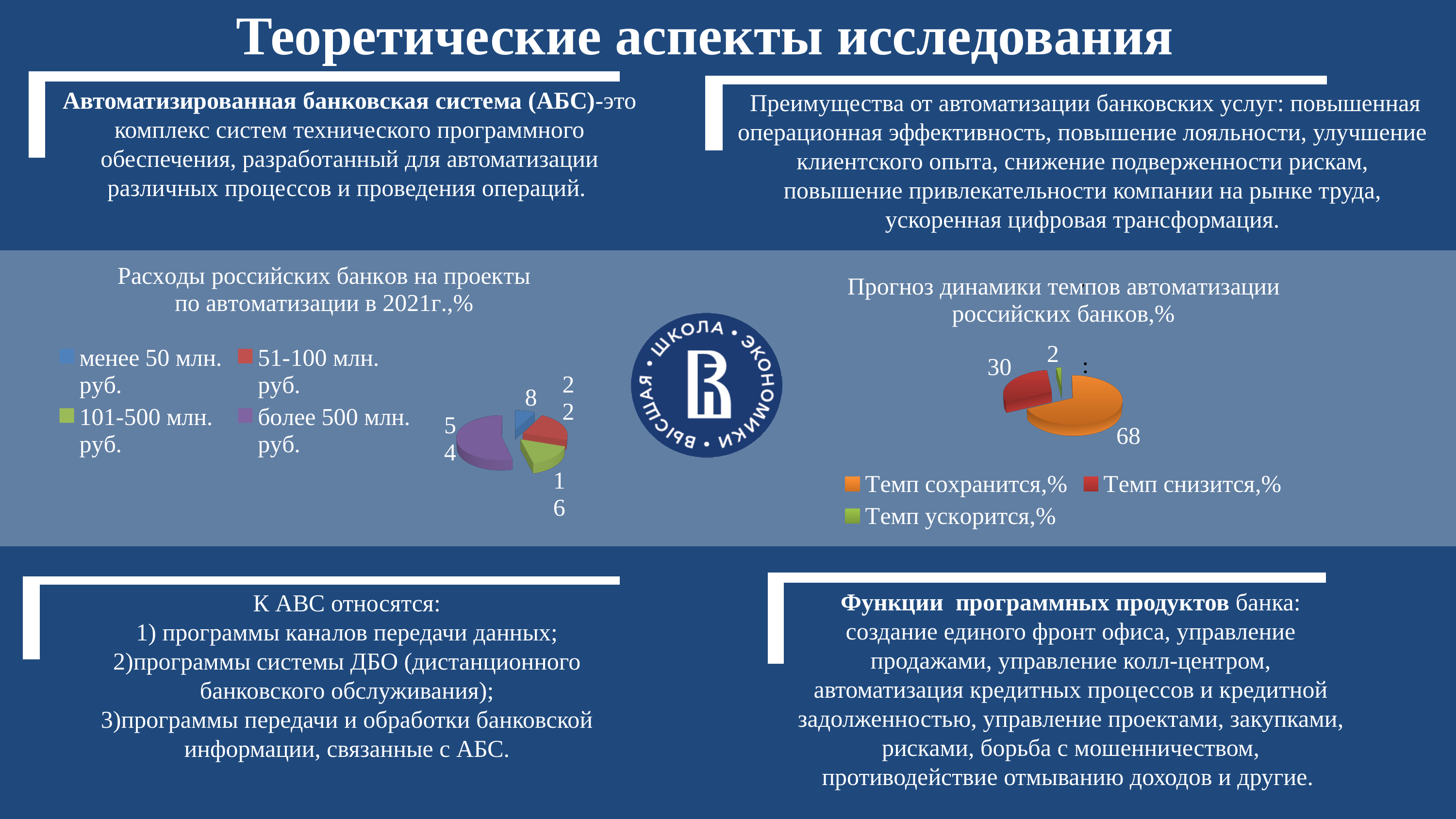
On the chart 'Расходы российских банков на проекты по автоматизации в 2021г.,%', which category has the smallest share? менее 50 млн. руб. On the chart 'Расходы российских банков на проекты по автоматизации в 2021г.,%', which category has the largest share? более 500 млн. руб. On the chart 'Прогноз динамики темпов автоматизации российских банков,%', how many categories does the legend list? 3 On the chart 'Прогноз динамики темпов автоматизации российских банков,%', which category has the largest share? Темп сохранится,% On the chart 'Расходы российских банков на проекты по автоматизации в 2021г.,%', how many categories does the legend list? 4 On the chart 'Расходы российских банков на проекты по автоматизации в 2021г.,%', what is the value for 'менее 50 млн. руб.'? 8 On the chart 'Прогноз динамики темпов автоматизации российских банков,%', what is the value for 'Темп снизится,%'? 30 On the chart 'Прогноз динамики темпов автоматизации российских банков,%', which category has the smallest share? Темп ускорится,% On the chart 'Прогноз динамики темпов автоматизации российских банков,%', what is the value for 'Темп сохранится,%'? 68 On the chart 'Прогноз динамики темпов автоматизации российских банков,%', what is the difference between 'Темп сохранится,%' and 'Темп снизится,%'? 38 What type of chart is 'Расходы российских банков на проекты по автоматизации в 2021г.,%'? pie chart On the chart 'Прогноз динамики темпов автоматизации российских банков,%', what is the value for 'Темп ускорится,%'? 2